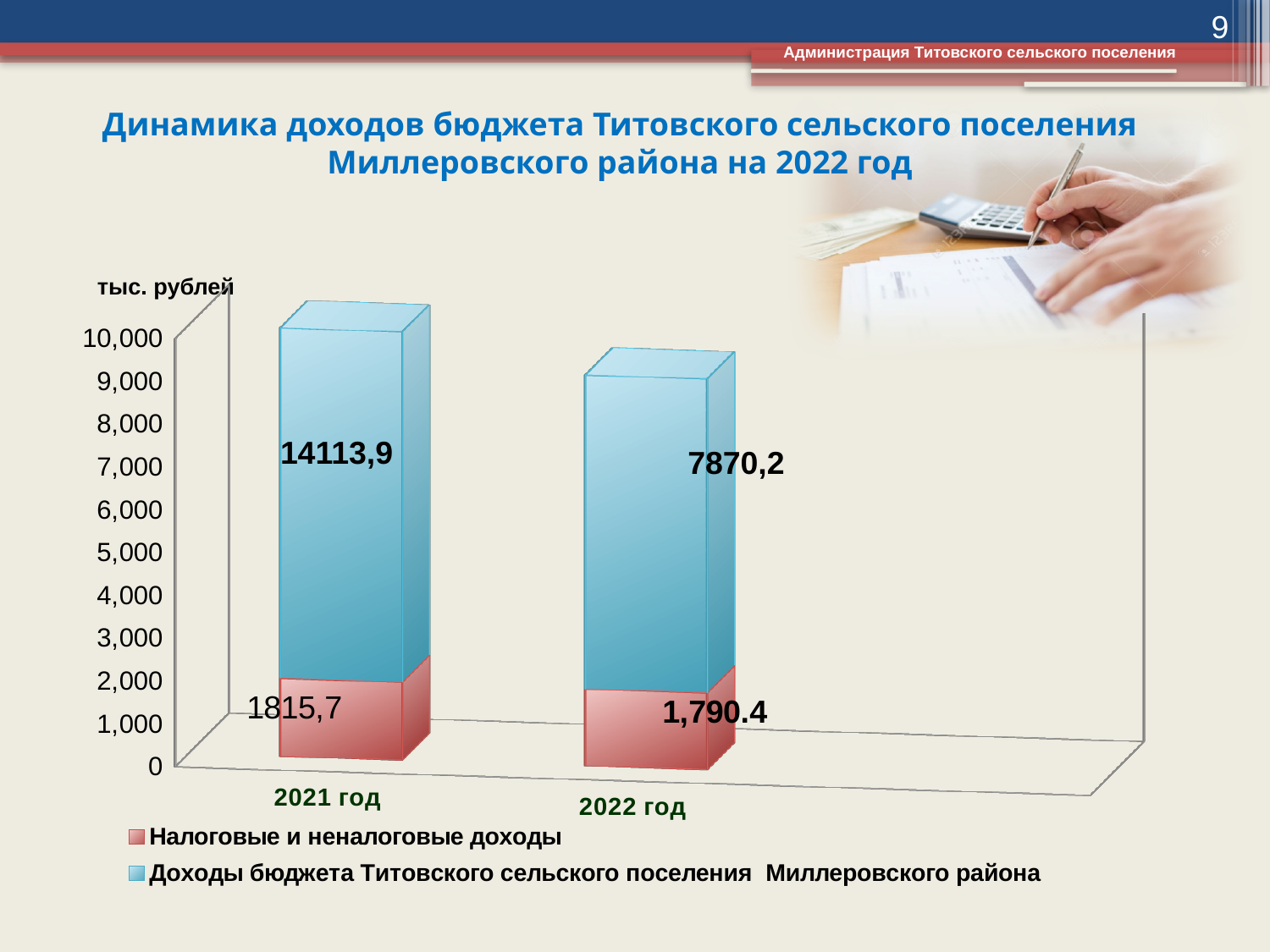
Which year has the lowest value for 'Налоговые и неналоговые доходы'? 2022 год What is the value of 'Налоговые и неналоговые доходы' for 2021 год? 1815,7 What kind of chart is shown on the slide? bar chart How many series does the chart legend list? 2 How many years (categories) are shown on the x axis of the chart? 2 What is the value of 'Доходы бюджета Титовского сельского поселения Миллеровского района' for 2021 год? 14113,9 Which year has the higher value for 'Доходы бюджета Титовского сельского поселения Миллеровского района', 2021 год or 2022 год? 2021 год What unit label is shown above the vertical axis of the chart? тыс. рублей Does the 'Доходы бюджета Титовского сельского поселения Миллеровского района' series rise or fall from 2021 год to 2022 год? fall What is the value of 'Доходы бюджета Титовского сельского поселения Миллеровского района' for 2022 год? 7870,2 What is the difference between the 'Доходы бюджета Титовского сельского поселения Миллеровского района' values for 2021 год and 2022 год? 6243,7 What is the value of 'Налоговые и неналоговые доходы' for 2022 год? 1,790.4